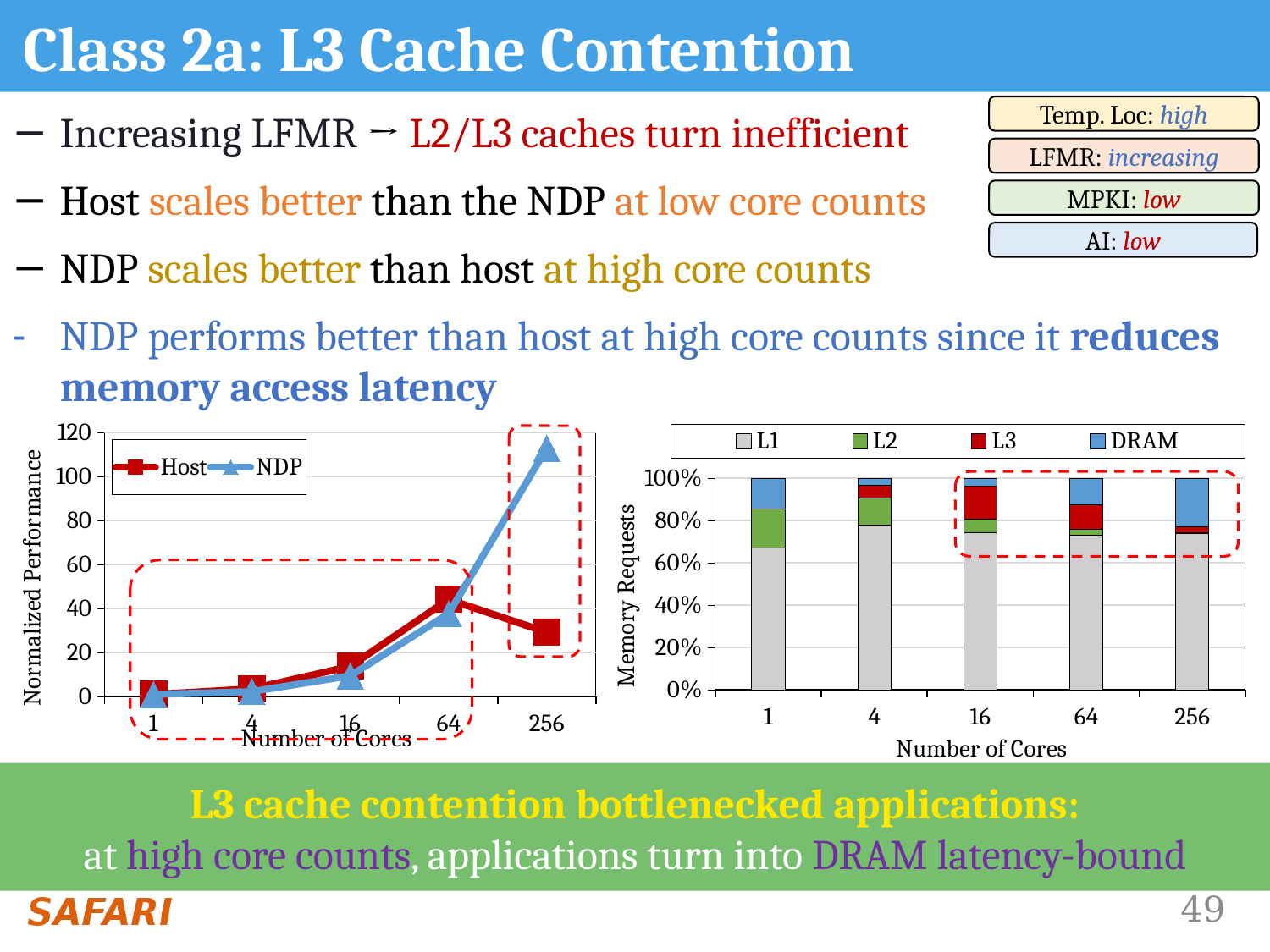
In the left chart, which series has the higher normalized performance at 64 cores, Host or NDP? Host In the left chart, at which number of cores does NDP reach its highest normalized performance? 256 In the left chart, is the NDP value at 256 cores greater or less than 100? greater In the right chart, at which number of cores is the L3 segment the largest? 16 In the right chart, is the L1 share of memory requests at 1 core greater or less than 80%? less In the right chart, how many series does the legend list? 4 What kind of chart is the right chart (Memory Requests vs Number of Cores)? stacked bar chart In the left chart, how many series does the legend list? 2 What kind of chart is the left chart (Normalized Performance vs Number of Cores)? line chart In the left chart, is the Host value at 256 cores greater or less than 40? less In the left chart, which series has the higher normalized performance at 256 cores, Host or NDP? NDP In the left chart, how many core-count categories are shown on the x axis? 5